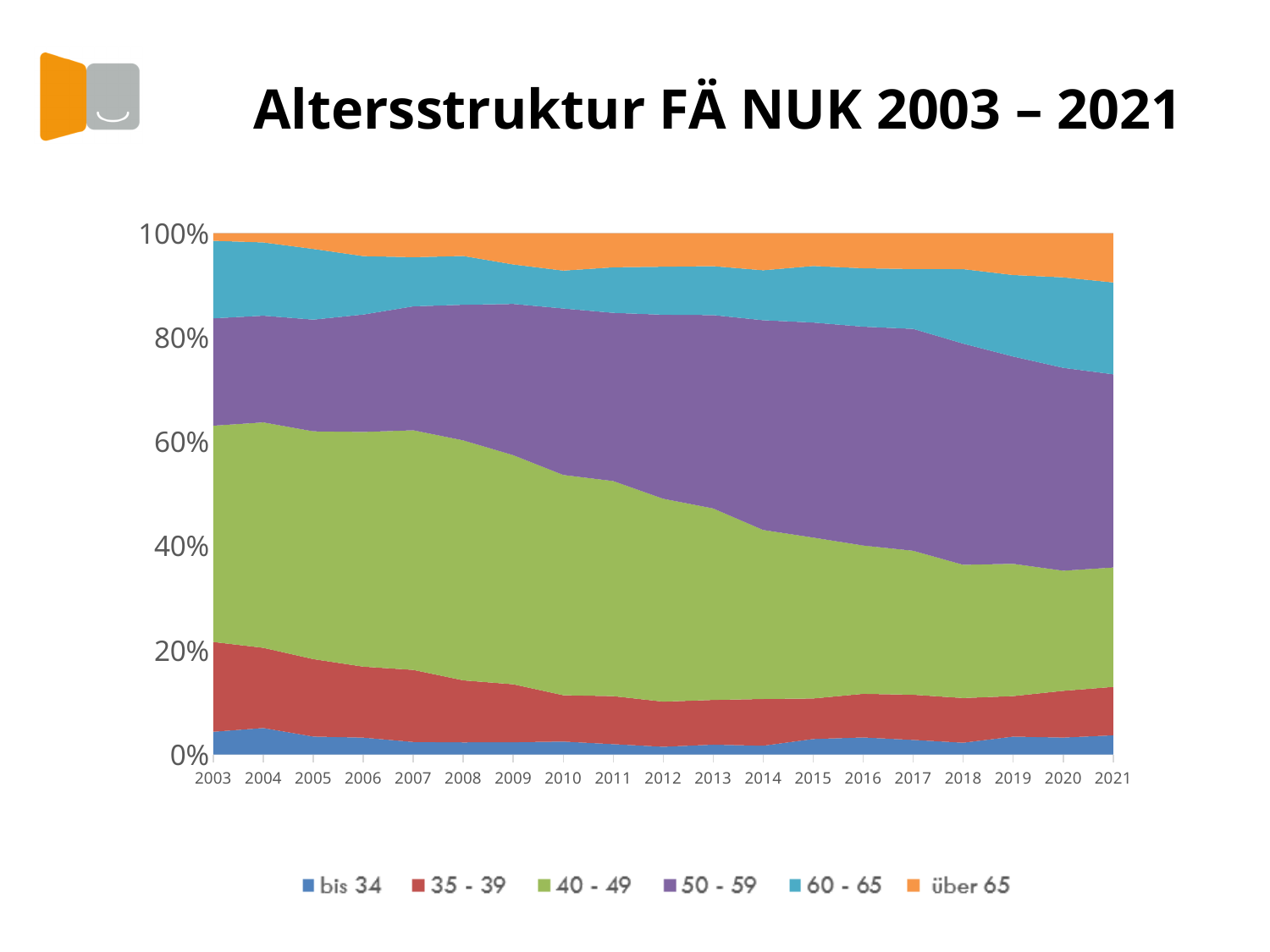
What kind of chart is shown on the slide? Stacked area chart In 2021, which has the larger share: 40 - 49 or 50 - 59? 50 - 59 Does the share of the über 65 age group rise or fall from 2003 to 2021? Rise Which age group is shown in green in the legend? 40 - 49 How many years are plotted along the x axis? 19 Which age group has the largest share in 2003? 40 - 49 Does the share of the 40 - 49 age group rise or fall from 2003 to 2021? Fall How many series does the legend list? 6 Does the share of the 50 - 59 age group rise or fall from 2003 to 2021? Rise Which age group has the largest share in 2021? 50 - 59 What is the title of the chart? Altersstruktur FÄ NUK 2003 – 2021 Is the share of the 40 - 49 age group in 2003 greater or less than 20%? greater